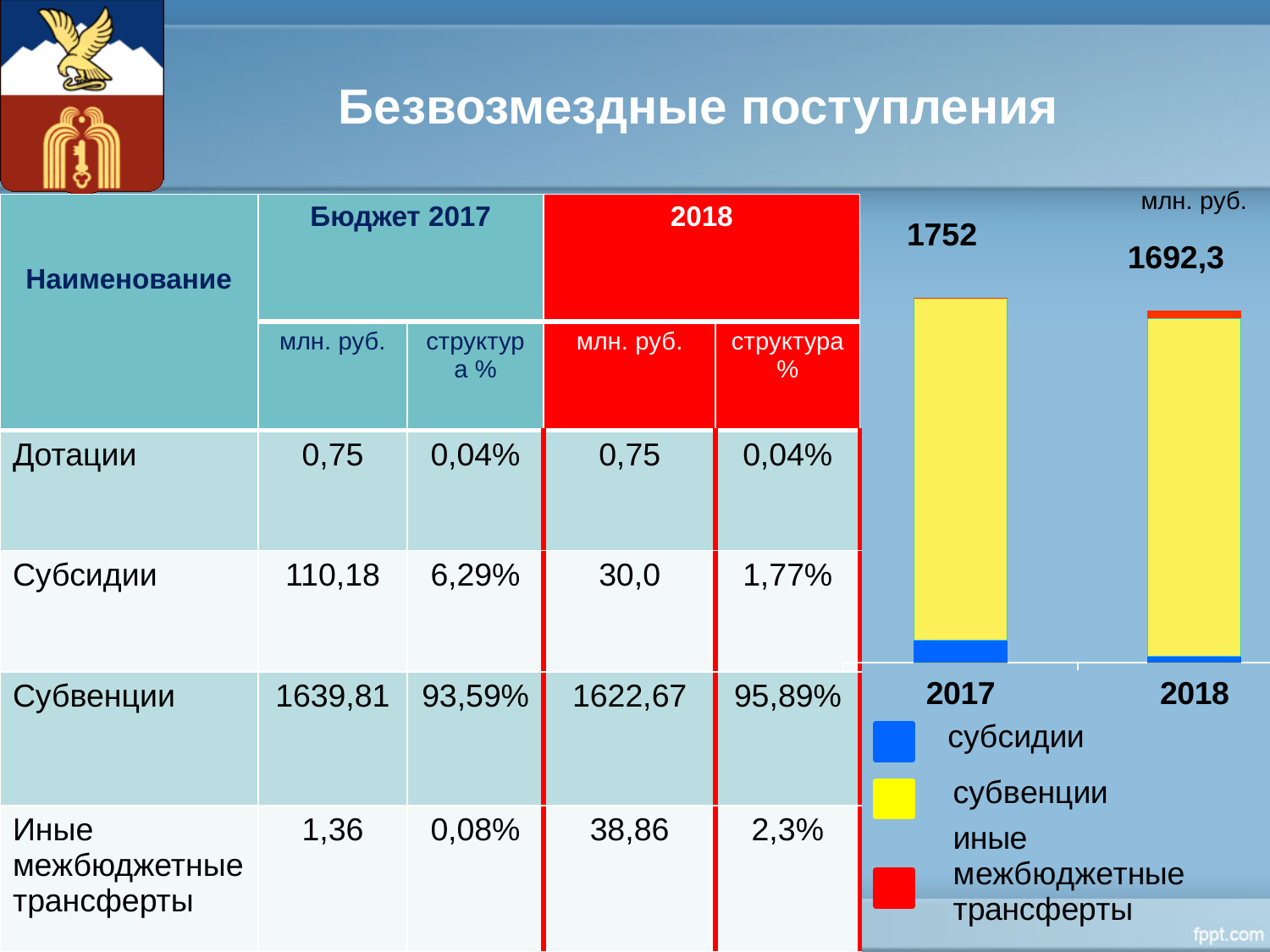
How many bars (years) are shown in the chart? 2 What unit is indicated in the top right corner of the chart? млн. руб. How many series does the chart legend list? 3 Which bar in the chart has the lowest total? 2018 Which series makes up the largest part of each bar in the chart? субвенции What is the difference between the 2017 total and the 2018 total in the chart? 59,7 What is the total value printed above the 2017 bar in the chart? 1752 Does the total value fall or rise from 2017 to 2018 in the chart? fall What is the total value printed above the 2018 bar in the chart? 1692,3 What type of chart is shown on the right side of the slide? stacked bar chart Which year has the higher total in the chart, 2017 or 2018? 2017 Which colour represents субсидии in the chart legend? blue